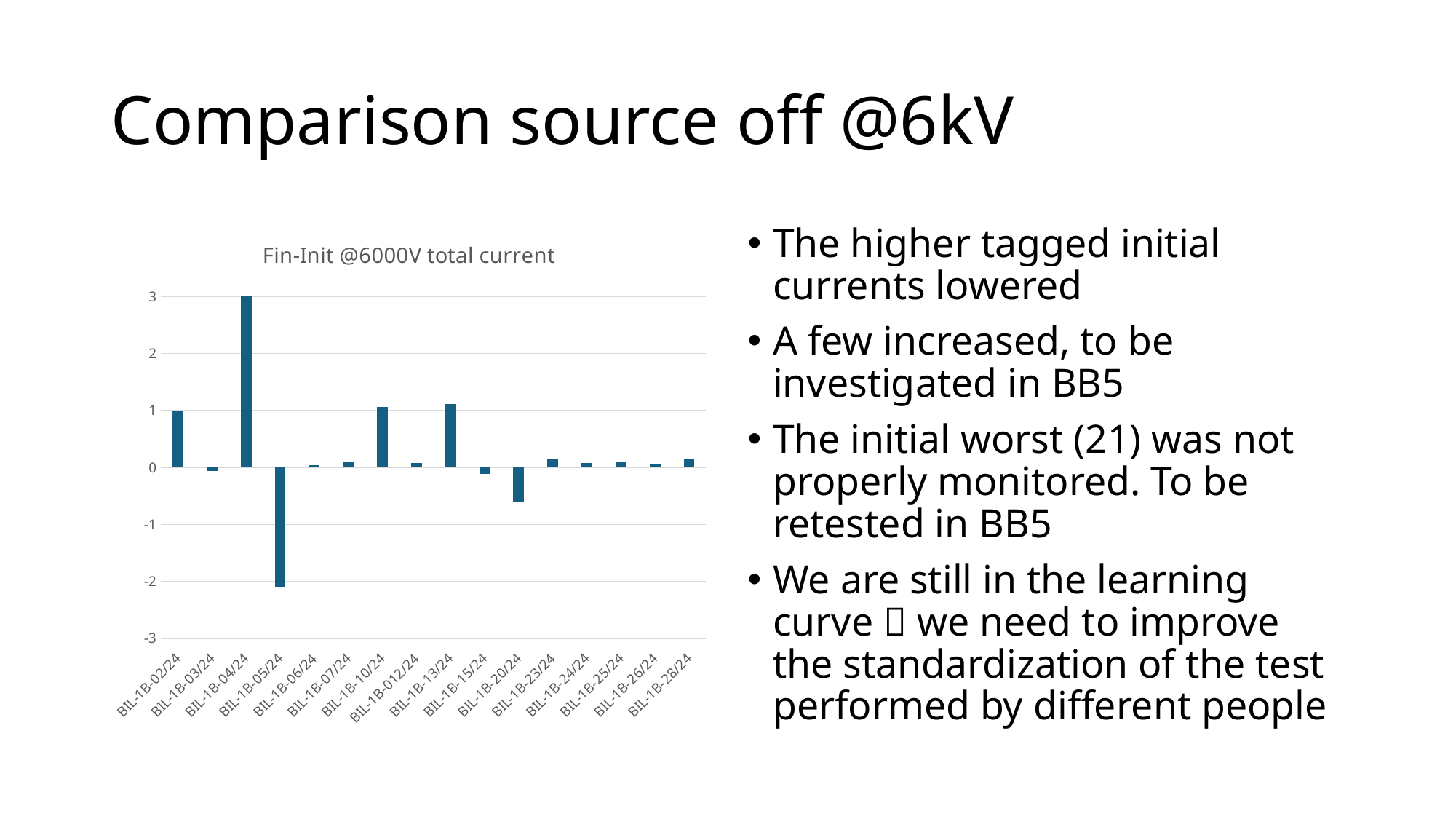
Is the value for BIL-1B-20/24 greater or less than -1? greater Which has the larger value, BIL-1B-04/24 or BIL-1B-13/24? BIL-1B-04/24 What is the title of the chart? Fin-Init @6000V total current Is the value for BIL-1B-20/24 greater or less than 0? less What kind of chart is shown on the slide? bar chart Is the value for BIL-1B-05/24 greater or less than -1? less Which category has the lowest value in the chart? BIL-1B-05/24 Which has the larger value, BIL-1B-02/24 or BIL-1B-20/24? BIL-1B-02/24 How many categories are plotted on the x axis of the chart? 16 Which category has the highest value in the chart? BIL-1B-04/24